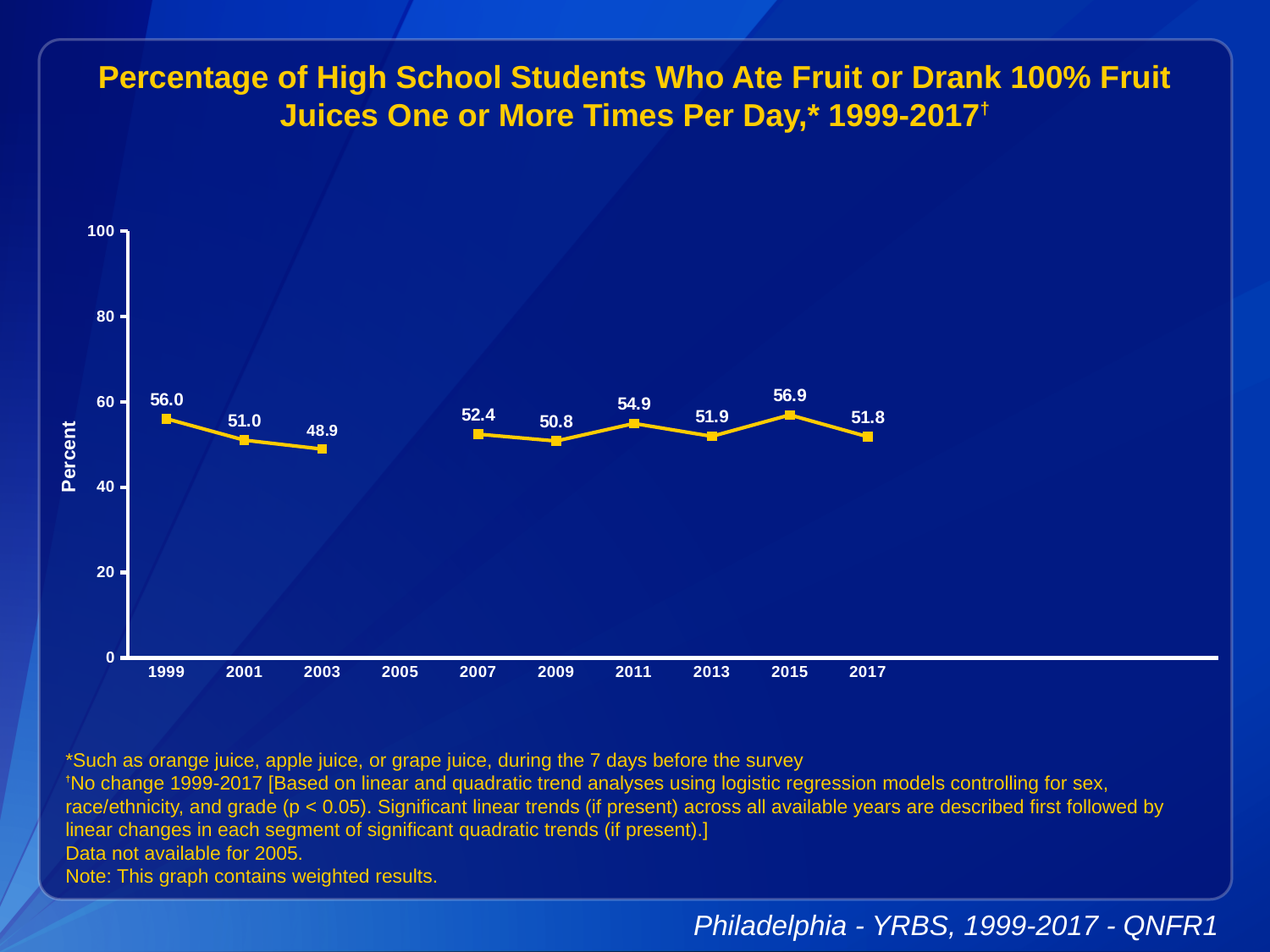
What is the difference between the values for 2015 and 2017? 5.1 How many years have data points plotted on the chart? 9 Which year has the highest plotted value? 2015 What is the value plotted for 2011? 54.9 Which year has the lowest plotted value? 2003 What kind of chart is shown on the slide? line chart For which year is data not available, according to the slide? 2005 Is the value for 2013 greater or less than 60? less What is the value plotted for 2017? 51.8 Which year has a larger value, 2007 or 2009? 2007 What is the difference between the values for 1999 and 2003? 7.1 What percentage of high school students ate fruit or drank 100% fruit juices one or more times per day in 1999? 56.0